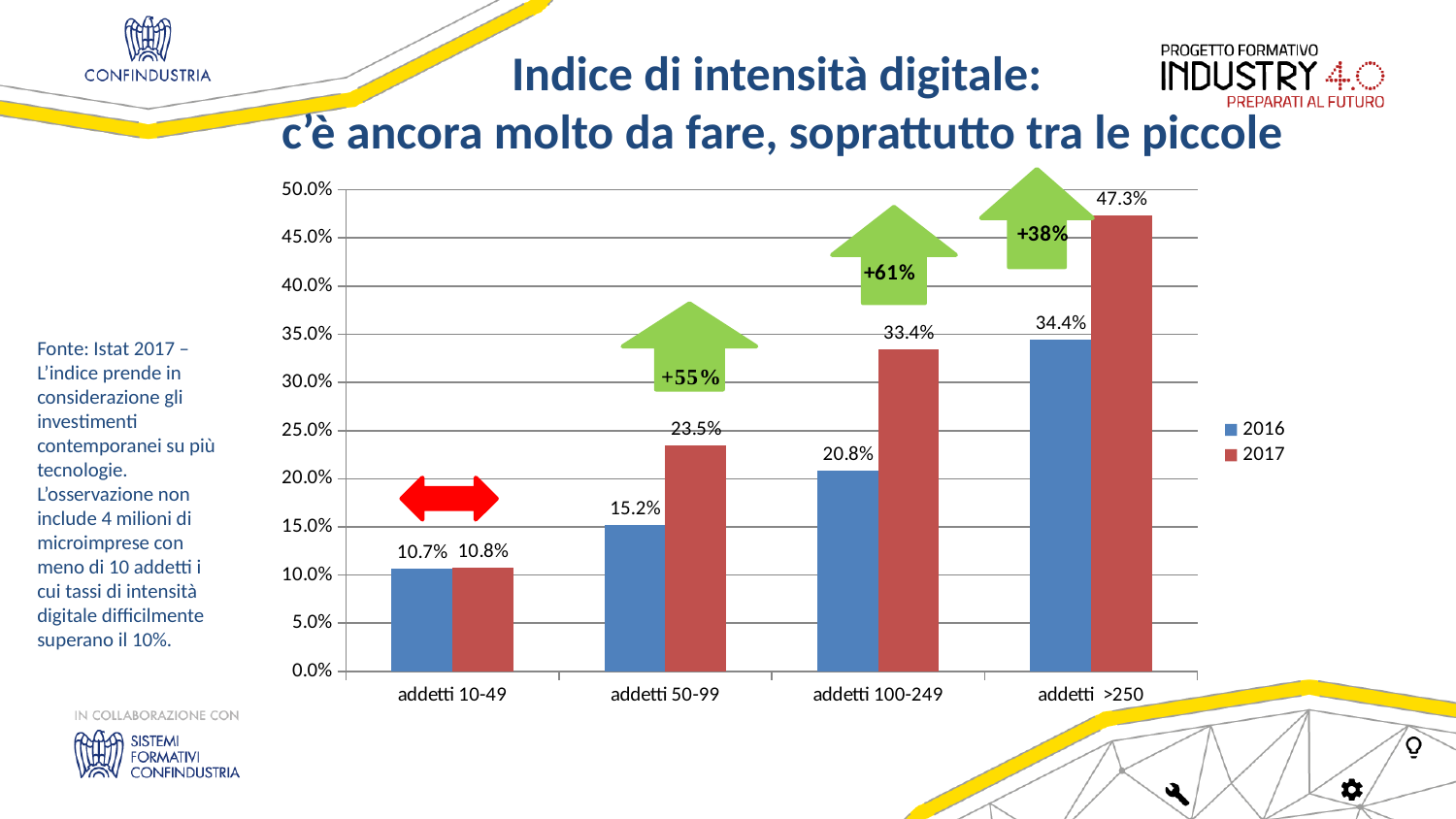
What kind of chart is shown on the slide? bar chart Which category has the lowest 2016 value? addetti 10-49 How many series does the legend list? 2 What is the 2017 value for addetti 100-249? 33.4% How many categories are shown on the x axis? 4 Do the 2017 values rise or fall from addetti 10-49 to addetti >250? rise Which is larger for addetti 50-99: the 2016 value or the 2017 value? 2017 What is the 2016 value for addetti 50-99? 15.2% What is the 2017 value for addetti >250? 47.3% What percentage increase is annotated above the addetti 100-249 bars? +61% What is the difference between the 2017 and 2016 values for addetti 100-249? 12.6% Which category has the highest 2017 value? addetti >250